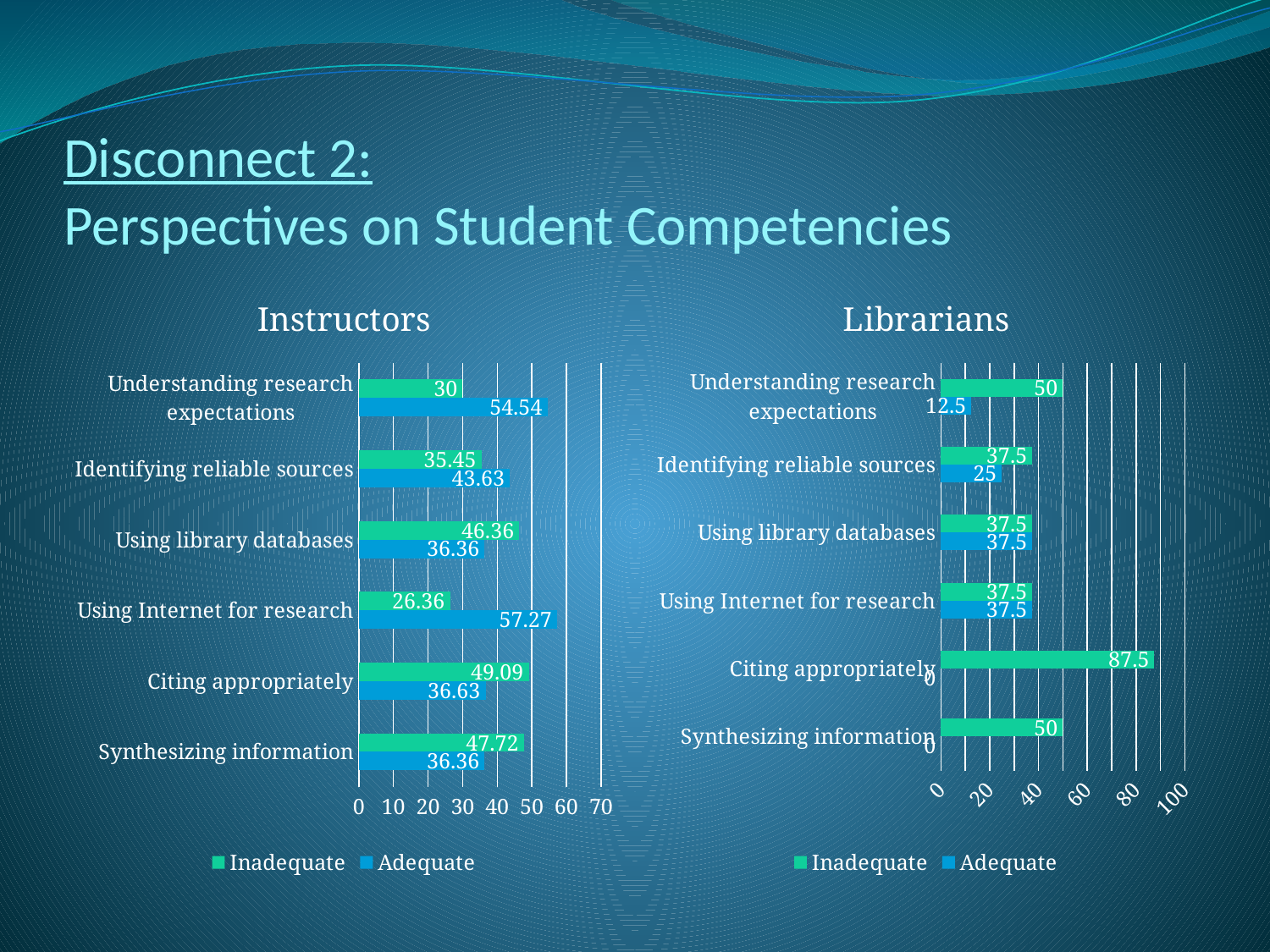
What type of chart is the Instructors chart? Bar chart In the Librarians chart, what is the difference between the Inadequate and Adequate values for Identifying reliable sources? 12.5 In the Librarians chart, which category has the highest Inadequate value? Citing appropriately How many categories are shown in the Librarians chart? 6 In the Instructors chart, which category has the highest Adequate value? Using Internet for research In the Instructors chart, which category has the lowest Inadequate value? Using Internet for research In the Librarians chart, what is the Adequate value for Understanding research expectations? 12.5 In the Librarians chart, what is the Inadequate value for Citing appropriately? 87.5 In the Instructors chart, what is the Adequate value for Using Internet for research? 57.27 In the Instructors chart, which is larger for Using library databases: the Inadequate value or the Adequate value? Inadequate In the Instructors chart, what is the Inadequate value for Citing appropriately? 49.09 In the Instructors chart, what is the difference between the Adequate and Inadequate values for Understanding research expectations? 24.54